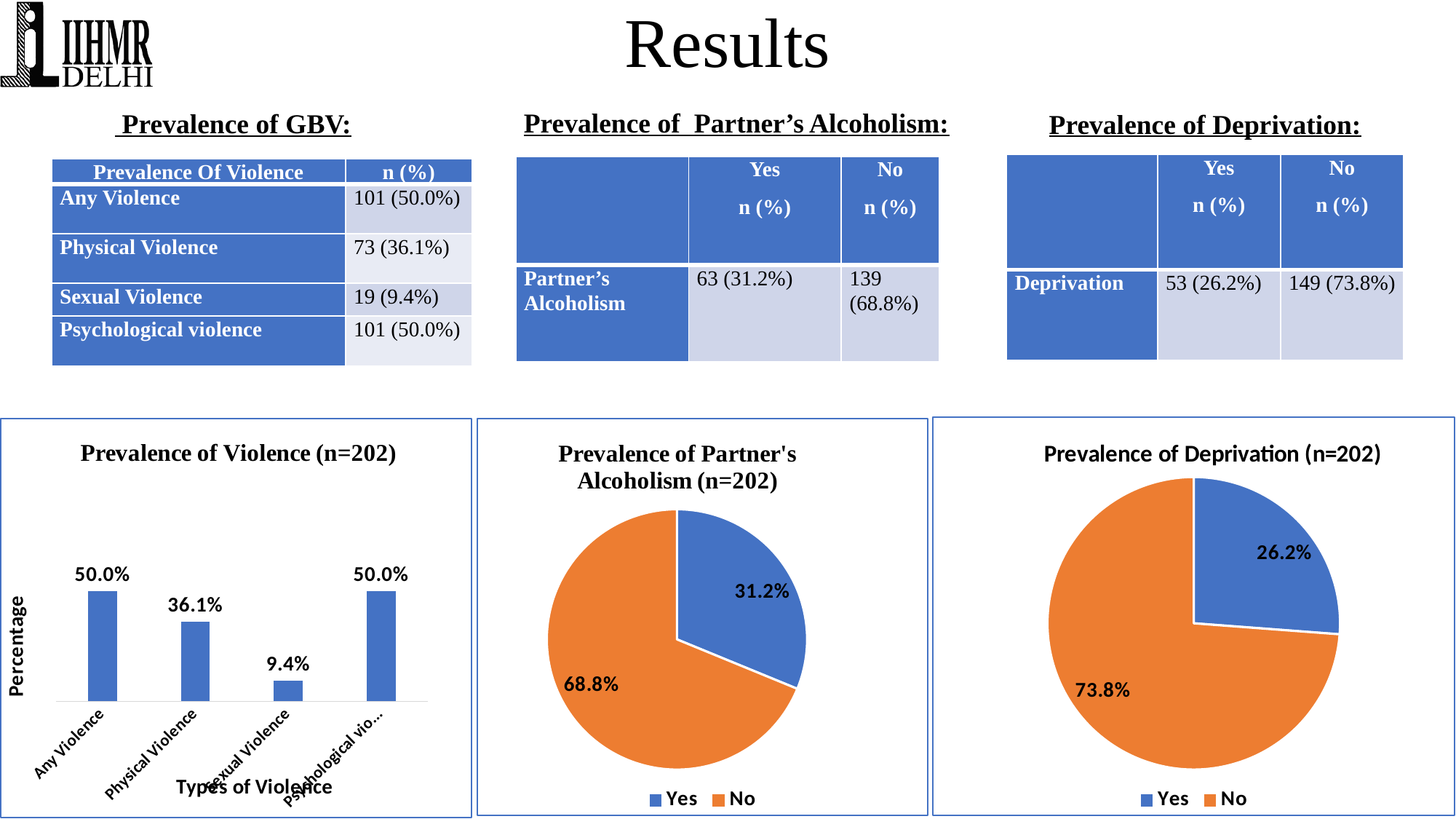
In the 'Prevalence of Violence (n=202)' chart, what is the difference between the values for Physical Violence and Sexual Violence? 26.7% In the 'Prevalence of Violence (n=202)' chart, what is the value for Physical Violence? 36.1% How many bars are in the 'Prevalence of Violence (n=202)' chart? 4 In the 'Prevalence of Violence (n=202)' chart, what is the value for Sexual Violence? 9.4% In the 'Prevalence of Deprivation (n=202)' chart, what share of the pie is 'No'? 73.8% In the 'Prevalence of Violence (n=202)' chart, which is larger, the value for Any Violence or the value for Physical Violence? Any Violence How many entries does the legend of the 'Prevalence of Deprivation (n=202)' chart list? 2 In the 'Prevalence of Deprivation (n=202)' chart, what is the difference between the 'No' and 'Yes' shares? 47.6% What kind of chart is 'Prevalence of Violence (n=202)'? Bar chart In the 'Prevalence of Partner's Alcoholism (n=202)' chart, what share of the pie is 'Yes'? 31.2% In the 'Prevalence of Partner's Alcoholism (n=202)' chart, which slice is larger, 'Yes' or 'No'? No In the 'Prevalence of Violence (n=202)' chart, which type of violence has the lowest value? Sexual Violence